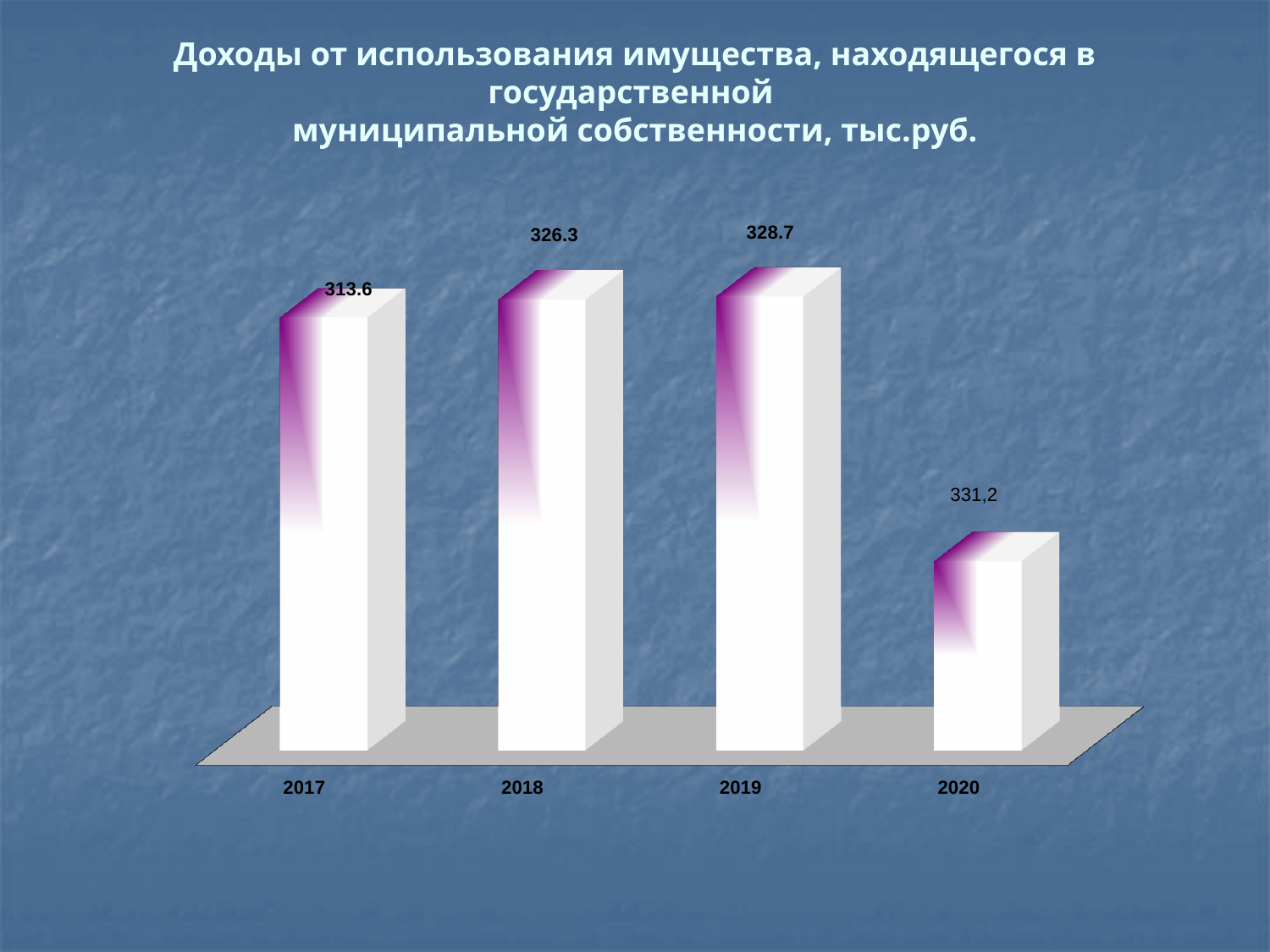
What is the value labelled for 2020? 331,2 What is the value shown for 2018? 326.3 What is the value shown for 2019? 328.7 What kind of chart is shown on the slide? bar chart In what units are the values given according to the chart title? тыс.руб. Which is larger, the value for 2018 or the value for 2019? 2019 What is the difference between the values for 2018 and 2017? 12.7 What is the difference between the values for 2019 and 2017? 15.1 How many years are shown on the x axis of the chart? 4 What is the value shown for 2017? 313.6 Do the labelled values rise or fall from 2017 to 2019? rise Which is larger, the value for 2017 or the value for 2018? 2018